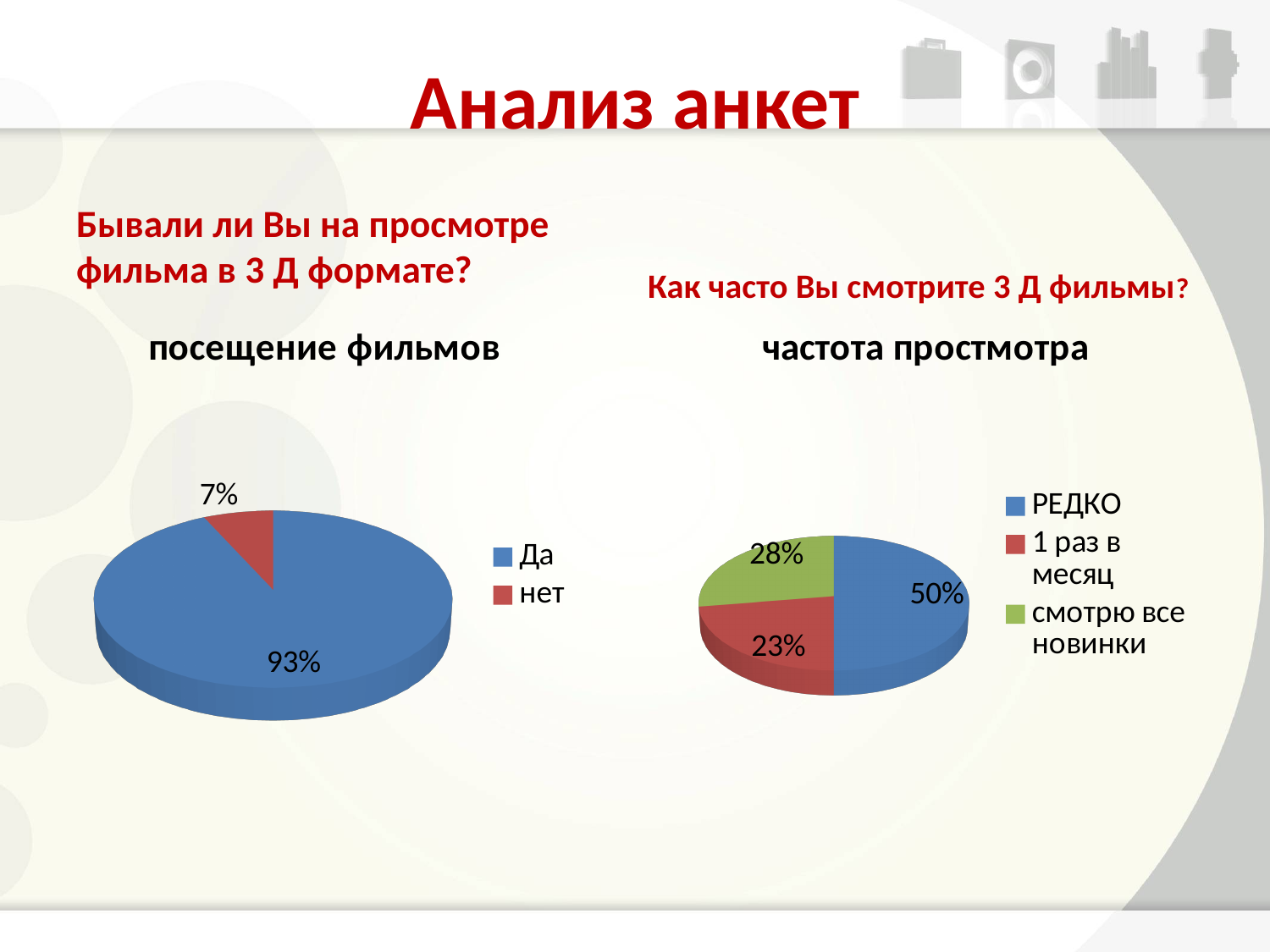
How many categories does the legend of the 'посещение фильмов' chart list? 2 What type of chart is the 'частота простмотра' chart? Pie chart In the 'посещение фильмов' chart, what share of respondents answered 'нет'? 7% In the 'частота простмотра' chart, what share corresponds to '1 раз в месяц'? 23% How many categories does the legend of the 'частота простмотра' chart list? 3 In the 'частота простмотра' chart, which is larger: 'смотрю все новинки' or '1 раз в месяц'? смотрю все новинки In the 'посещение фильмов' chart, what is the difference between the 'Да' and 'нет' shares? 86% In the 'частота простмотра' chart, which category has the smallest slice? 1 раз в месяц In the 'посещение фильмов' chart, what share of respondents answered 'Да'? 93% In the 'частота простмотра' chart, what share corresponds to 'РЕДКО'? 50% In the 'посещение фильмов' chart, which category has the largest slice? Да In the 'частота простмотра' chart, what share corresponds to 'смотрю все новинки'? 28%